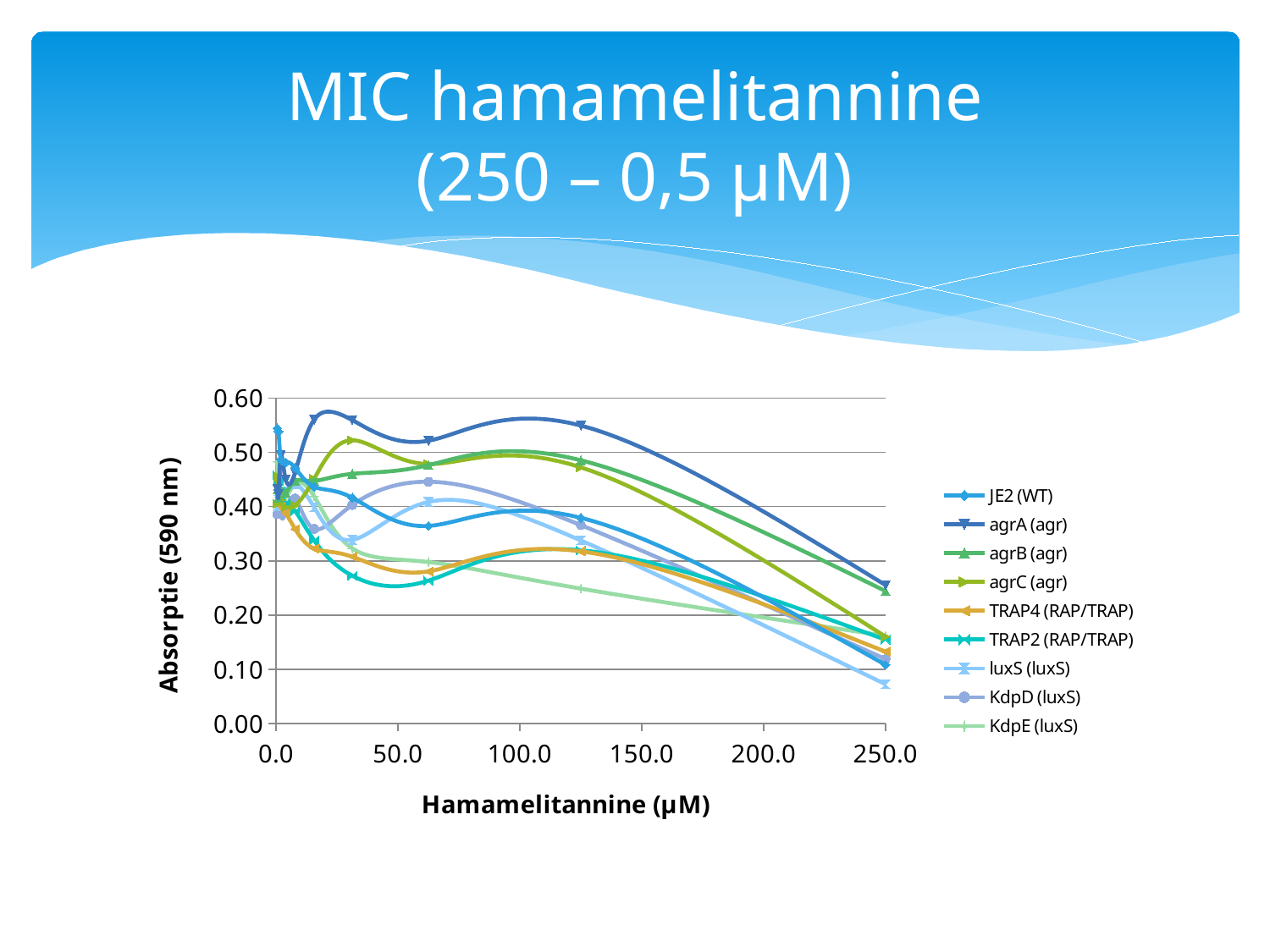
What kind of chart is shown on the slide? line chart Is the absorptie for KdpE (luxS) at 250 µM greater or less than 0.20? less Does the absorptie for agrA (agr) rise or fall between 125 µM and 250 µM? fall Which series has the highest absorptie at 125 µM hamamelitannine? agrA (agr) What is the title of the x axis? Hamamelitannine (µM) Is the absorptie for agrA (agr) at 250 µM greater or less than 0.20? greater How many series does the legend list? 9 Is the absorptie for luxS (luxS) at 250 µM greater or less than 0.10? less What is the title of the y axis? Absorptie (590 nm) At 125 µM, which series has the larger absorptie, agrA (agr) or TRAP4 (RAP/TRAP)? agrA (agr) Which series has the lowest absorptie at 250 µM hamamelitannine? luxS (luxS)